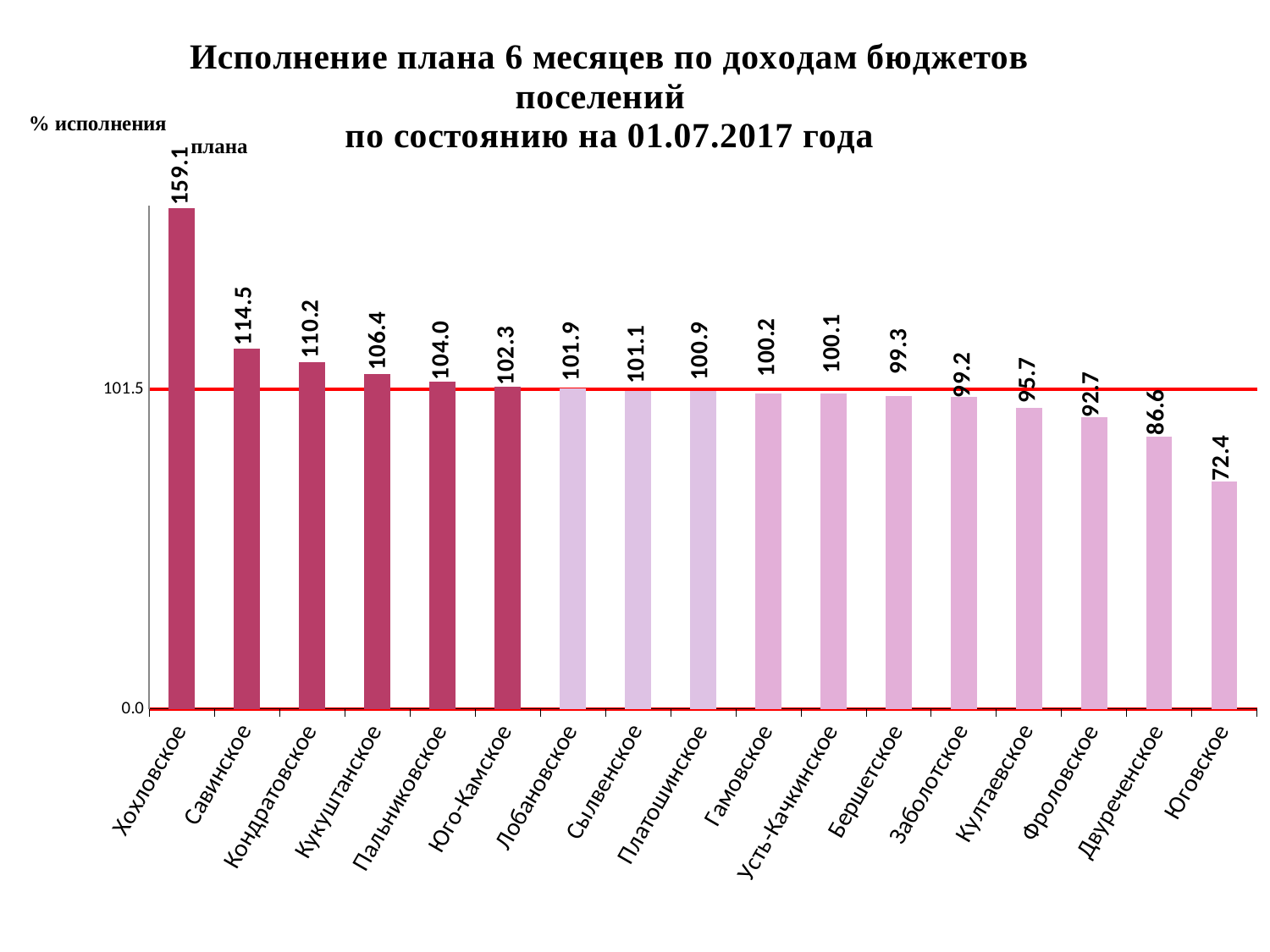
Do the values rise or fall from left to right along the x axis? fall How many settlements are shown on the chart? 17 What value is marked by the horizontal red line on the chart? 101.5 Which is larger, the value for Култаевское or the value for Двуреченское? Култаевское Which settlement has the highest value? Хохловское Which settlement has the lowest value? Юговское What is the difference between the values for Савинское and Кондратовское? 4.3 What kind of chart is shown on the slide? bar chart What is the value for Фроловское? 92.7 What is the difference between the values for Хохловское and Юговское? 86.7 What is the value for Кукуштанское? 106.4 What is the value for Хохловское? 159.1